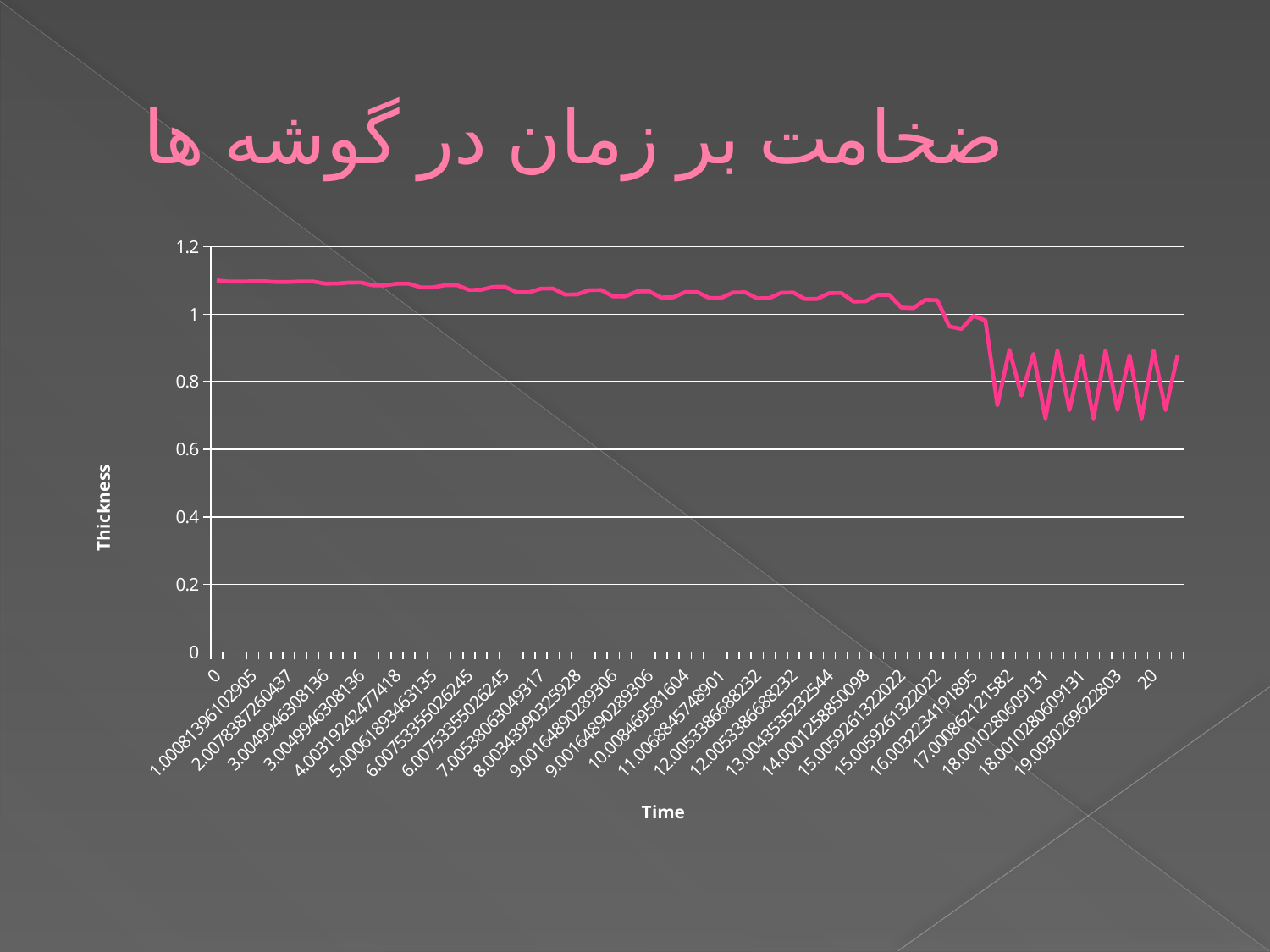
What is the title of the horizontal axis? Time Is the Thickness value at Time 0 greater or less than 1.2? less What kind of chart is shown on the slide? line chart What is the title of the vertical axis? Thickness Is the Thickness value at Time 5.00061893463135 greater or less than 0.8? greater Is the Thickness value at Time 18.0010280609131 greater or less than 1? less Is the Thickness value at Time 0 larger or smaller than the value at Time 20? larger Do the Thickness values generally rise or fall as Time increases along the x axis? fall